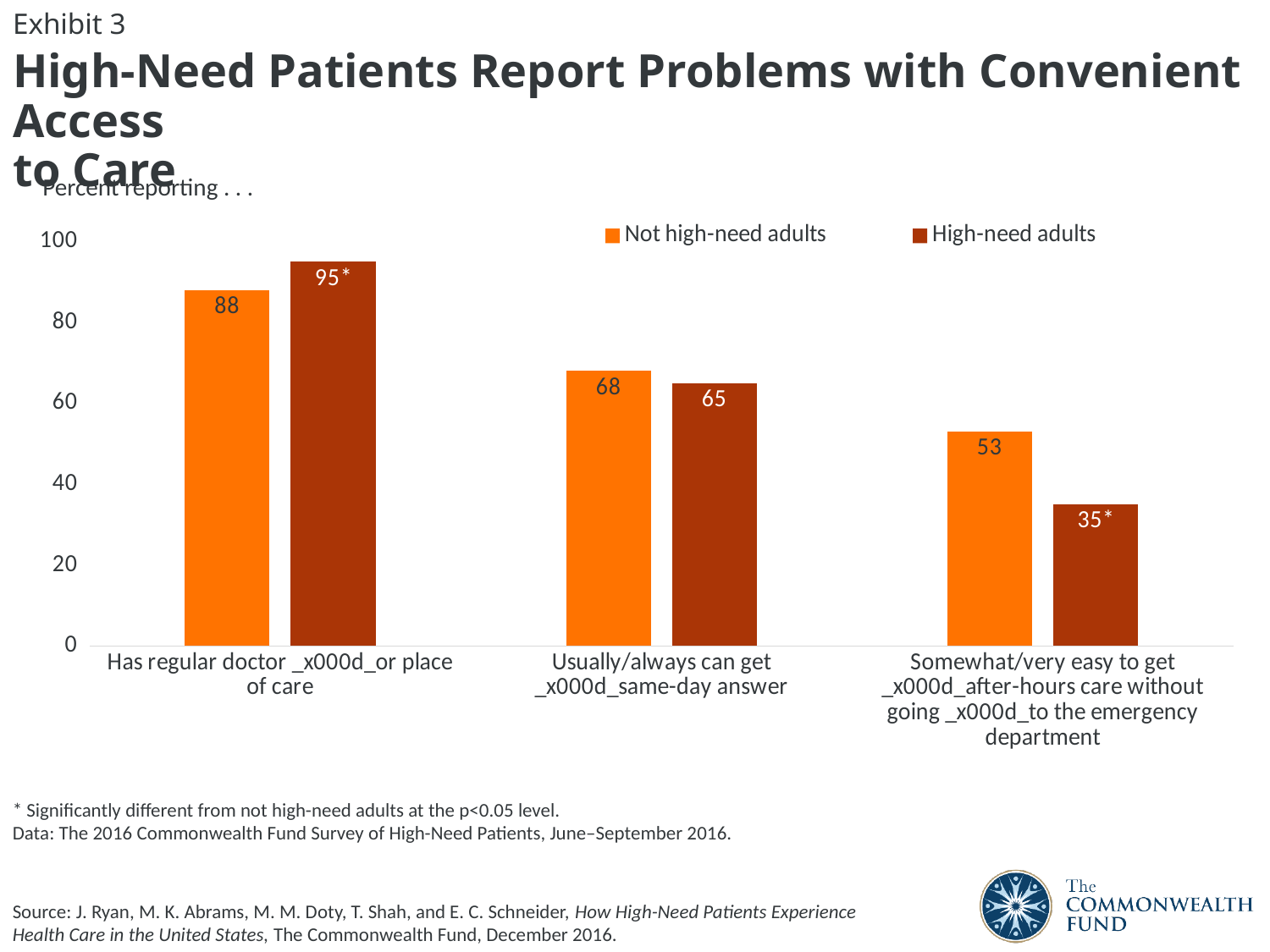
What is the value for High-need adults for 'Has regular doctor or place of care'? 95 What is the value for Not high-need adults for 'Usually/always can get same-day answer'? 68 What kind of chart is shown on the slide? Bar chart Which category has the lowest value for Not high-need adults? Somewhat/very easy to get after-hours care without going to the emergency department Which series is shown in the darker red-brown colour? High-need adults How many categories are shown on the x axis? 3 How many series does the legend list? 2 What is the difference between Not high-need adults and High-need adults for 'Somewhat/very easy to get after-hours care without going to the emergency department'? 18 For 'Usually/always can get same-day answer', which is larger: Not high-need adults or High-need adults? Not high-need adults What is the value for Not high-need adults for 'Has regular doctor or place of care'? 88 What is the value for High-need adults for 'Somewhat/very easy to get after-hours care without going to the emergency department'? 35 Which category has the highest value for High-need adults? Has regular doctor or place of care